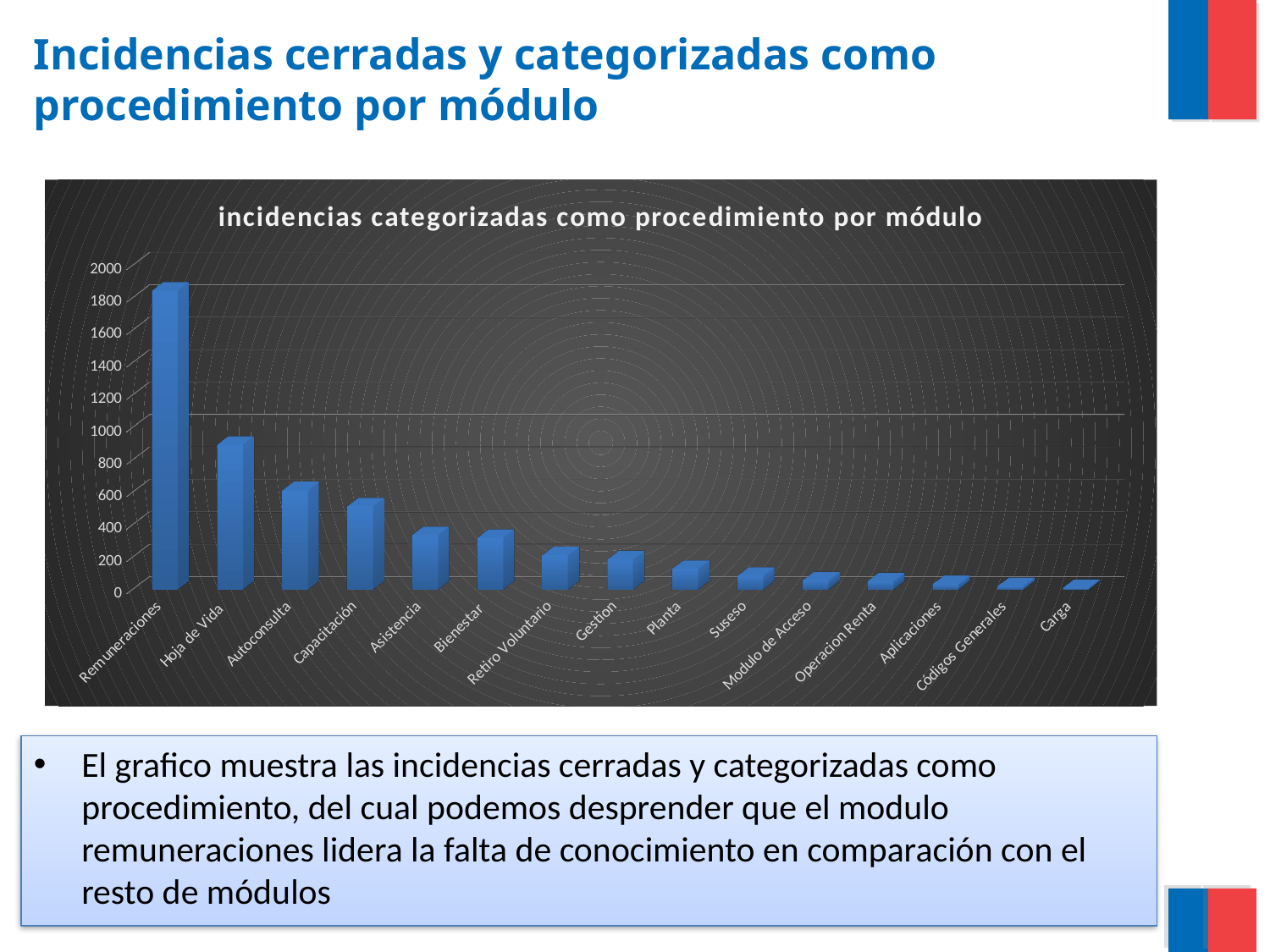
Is the value for Capacitación greater or less than 800? less Is the value for Hoja de Vida greater or less than 1200? less Is the value for Remuneraciones greater or less than 1600? greater Which module has the highest number of incidents? Remuneraciones Do the values rise or fall moving from left to right along the x axis? Fall How many modules (categories) are plotted on the x axis? 15 What kind of chart is shown on the slide? Bar chart Which has more incidents, Hoja de Vida or Autoconsulta? Hoja de Vida Which has more incidents, Remuneraciones or Capacitación? Remuneraciones What is the title of the chart? incidencias categorizadas como procedimiento por módulo